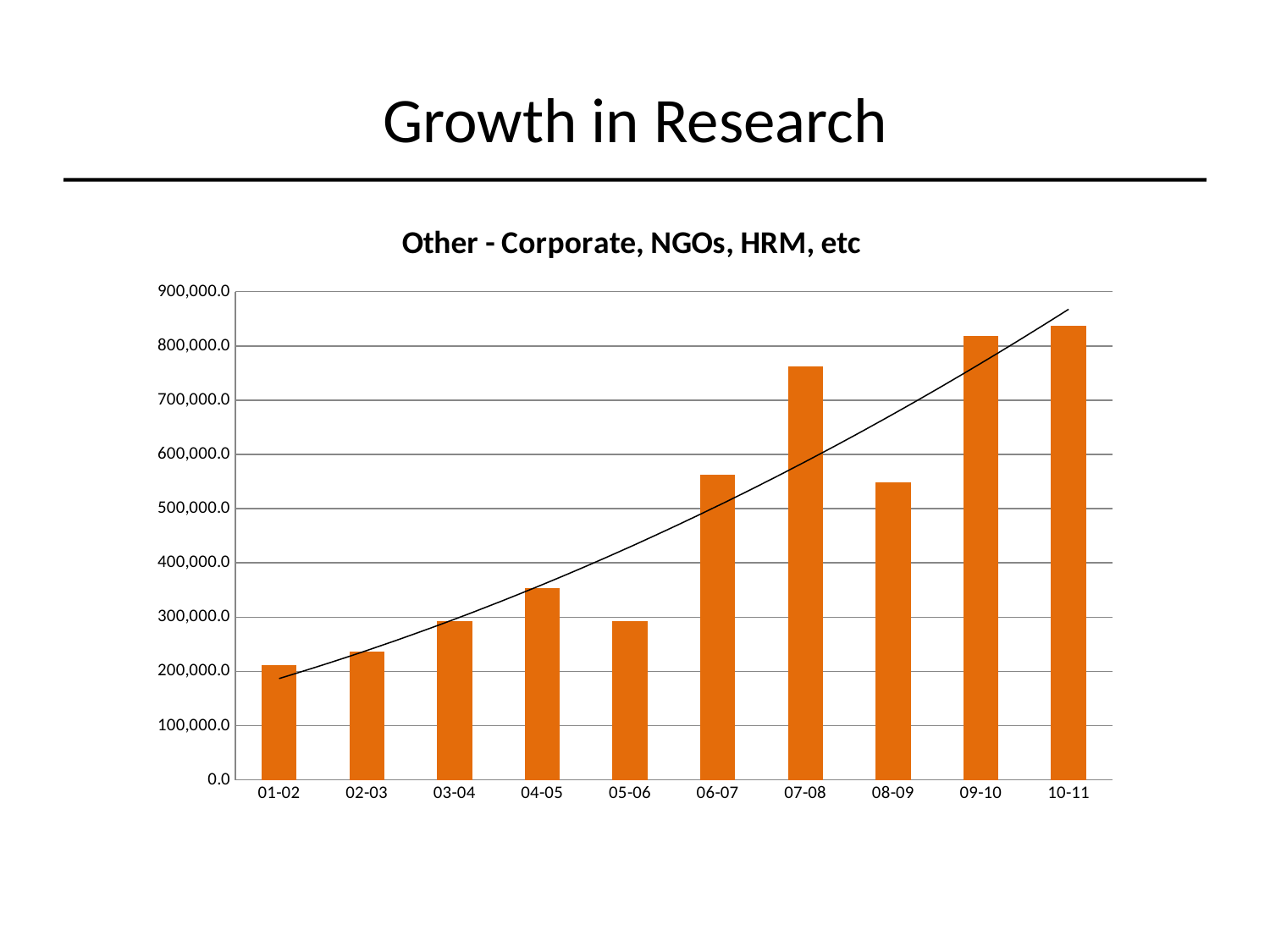
Is the value for 06-07 greater or less than 500,000? greater Which is larger, the value for 04-05 or the value for 02-03? 04-05 Which year has the lowest bar in the chart? 01-02 Is the value for 09-10 greater or less than 800,000? greater Is the value for 07-08 greater or less than 700,000? greater Do the values generally rise or fall from 01-02 to 10-11? rise Which is larger, the value for 07-08 or the value for 08-09? 07-08 What kind of chart is shown on the slide? bar chart How many year categories are shown on the x axis of the chart? 10 What is the title of the chart? Other - Corporate, NGOs, HRM, etc